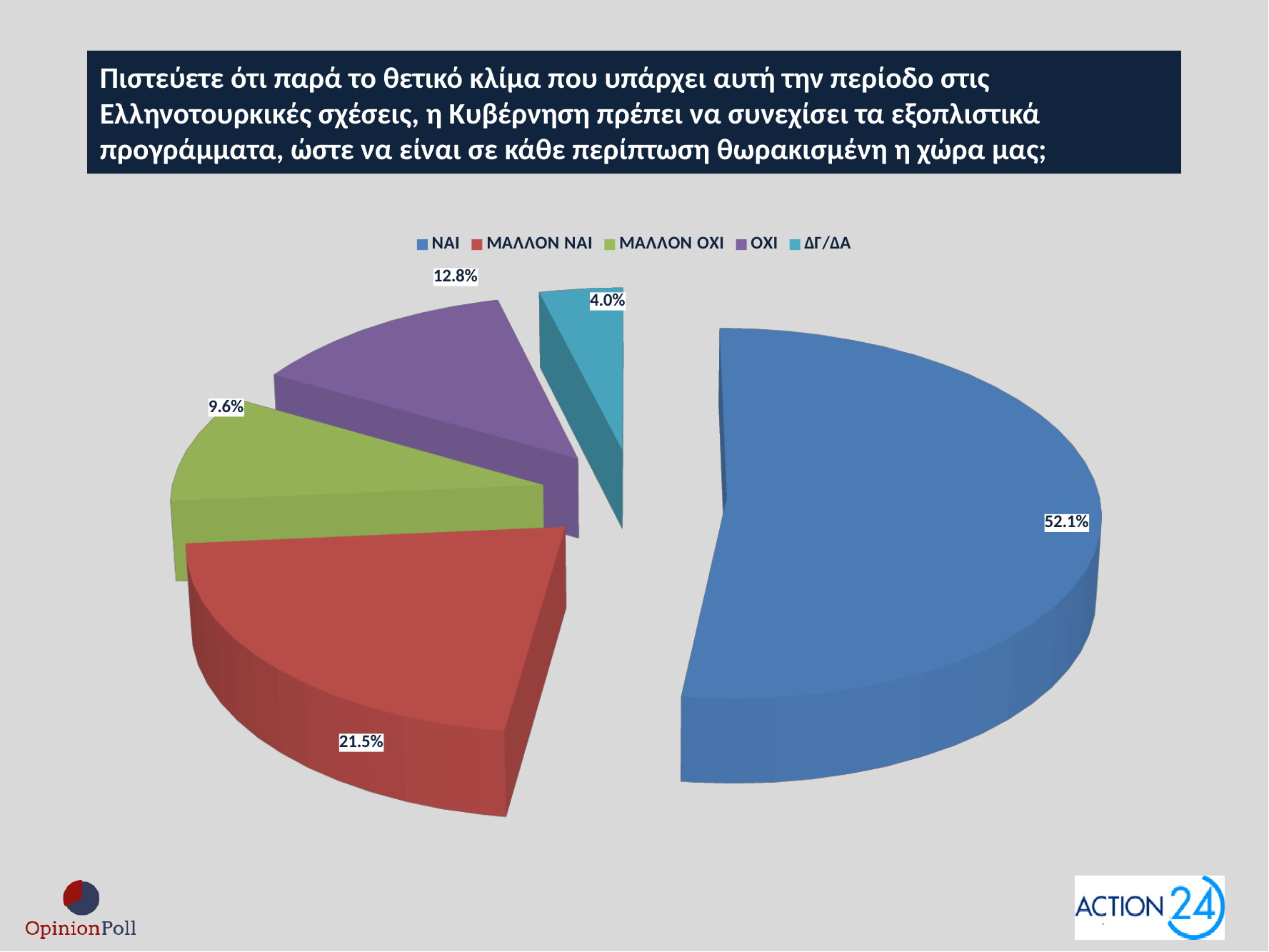
What percentage of respondents answered ΝΑΙ? 52.1% What percentage of respondents answered ΜΑΛΛΟΝ ΝΑΙ? 21.5% What kind of chart is shown on the slide? Pie chart How many categories does the pie chart have? 5 What is the difference in percentage points between ΝΑΙ and ΜΑΛΛΟΝ ΝΑΙ? 30.6 What percentage of respondents answered ΔΓ/ΔΑ? 4.0% Which response has the largest share of the pie? ΝΑΙ What colour is the slice for ΜΑΛΛΟΝ ΟΧΙ? Green Which response has the smallest share of the pie? ΔΓ/ΔΑ What percentage of respondents answered ΜΑΛΛΟΝ ΟΧΙ? 9.6% Which is larger, the share for ΟΧΙ or the share for ΜΑΛΛΟΝ ΟΧΙ? ΟΧΙ What percentage of respondents answered ΟΧΙ? 12.8%